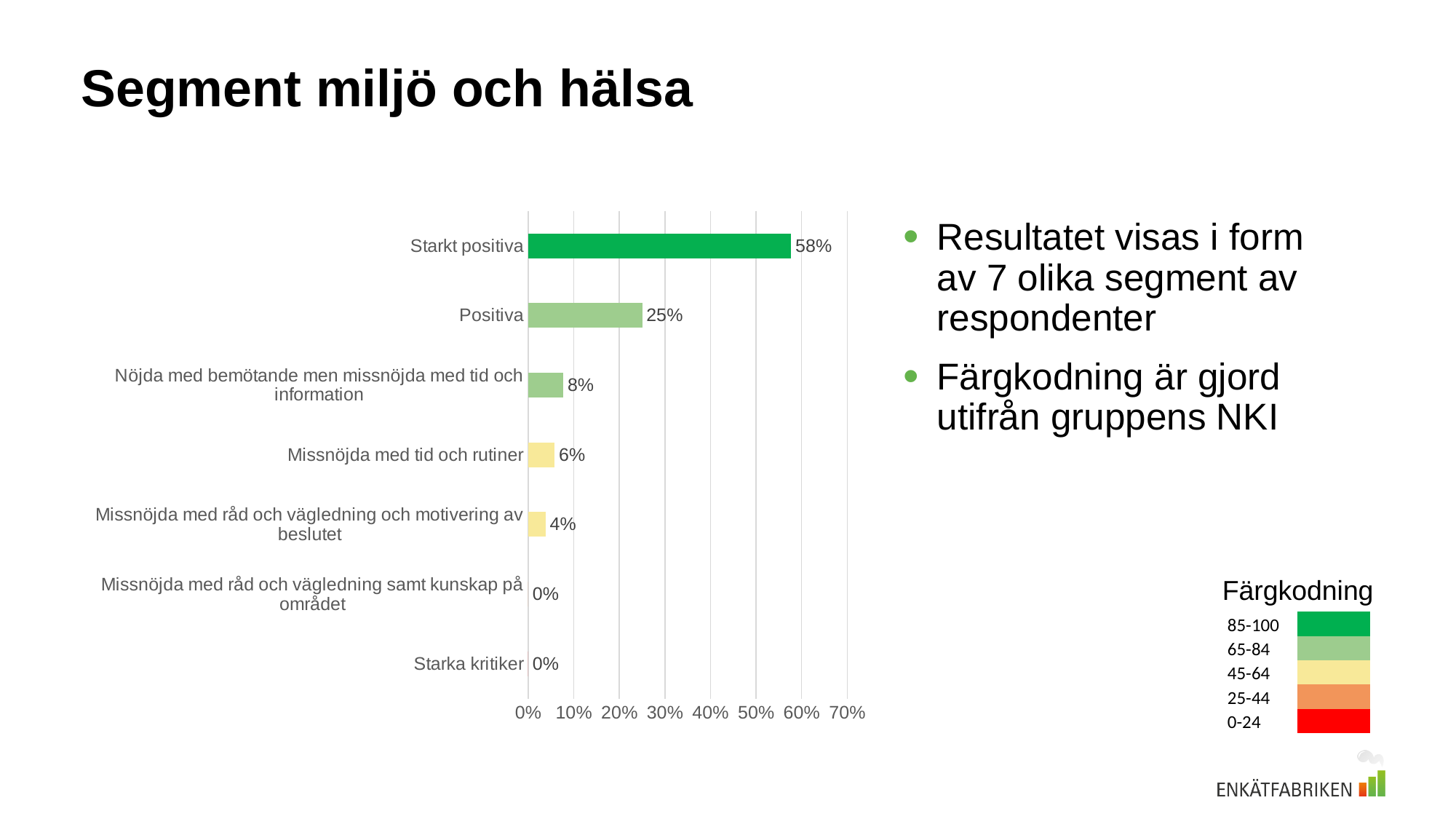
What is the value for Nöjda med bemötande men missnöjda med tid och information? 8% Which is larger, the value for Missnöjda med tid och rutiner or the value for Missnöjda med råd och vägledning och motivering av beslutet? Missnöjda med tid och rutiner What is the value for Missnöjda med tid och rutiner? 6% What is the title of the slide? Segment miljö och hälsa What is the difference between the values for Starkt positiva and Positiva? 33% Is the value for Starkt positiva greater or less than 50%? greater What is the value for Starkt positiva? 58% What is the value for Starka kritiker? 0% How many categories are shown on the chart? 7 What is the value for Positiva? 25% What kind of chart is shown on the slide? bar chart Which category has the highest value? Starkt positiva